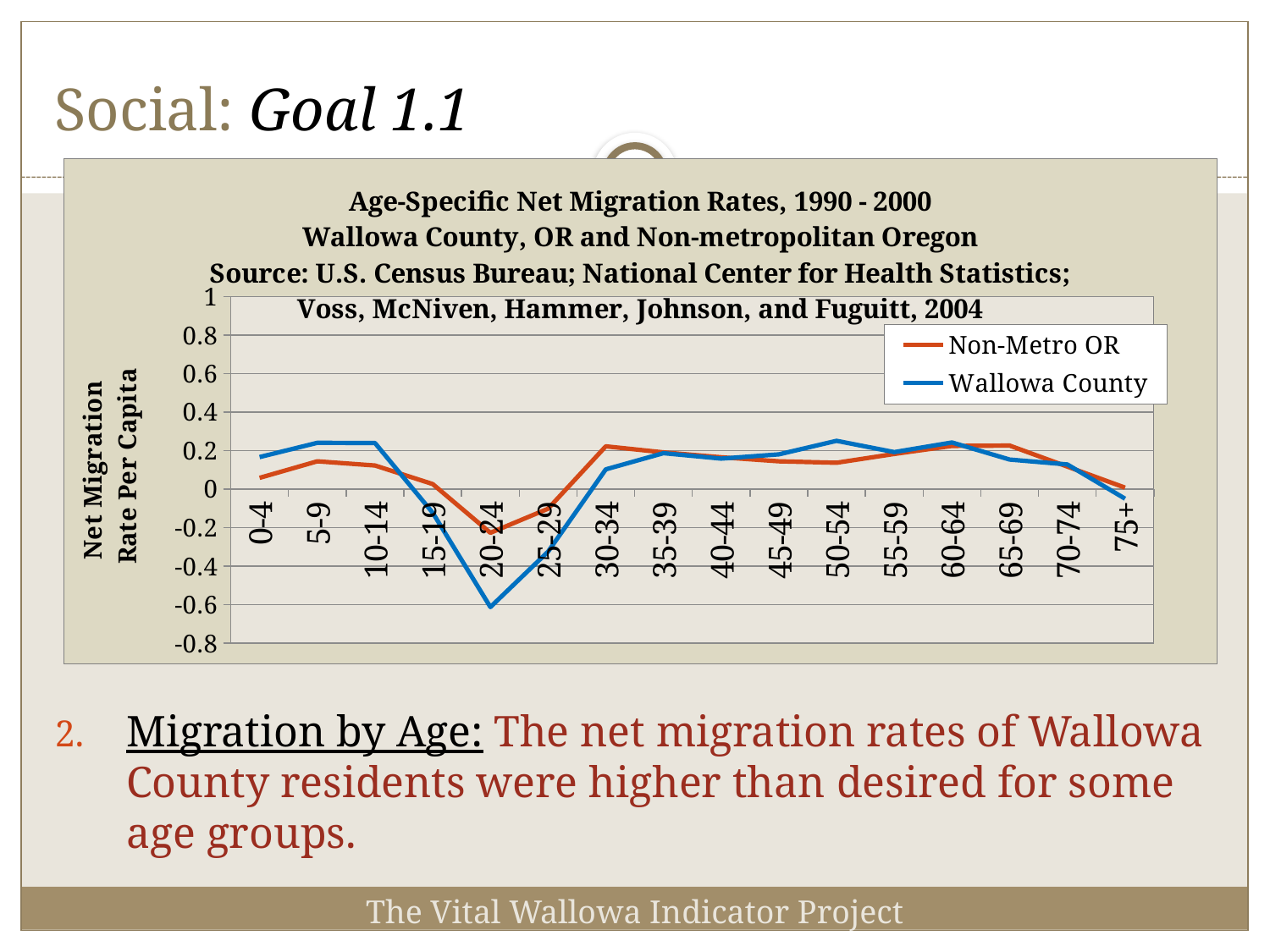
For the 20-24 age group, which series has the lower value, Non-Metro OR or Wallowa County? Wallowa County Which series is drawn with the blue line? Wallowa County Is the Non-Metro OR value for the 0-4 age group greater or less than 0.2? less Is the Wallowa County value for the 20-24 age group greater or less than -0.4? less What time period does the chart title say the net migration rates cover? 1990 - 2000 Is the Wallowa County value for the 50-54 age group greater or less than 0? greater For the 30-34 age group, which series has the higher value, Non-Metro OR or Wallowa County? Non-Metro OR What kind of chart is shown on the slide? Line chart How many series does the legend list? 2 How many age groups are shown along the x axis? 16 For which age group does the Wallowa County line reach its lowest value? 20-24